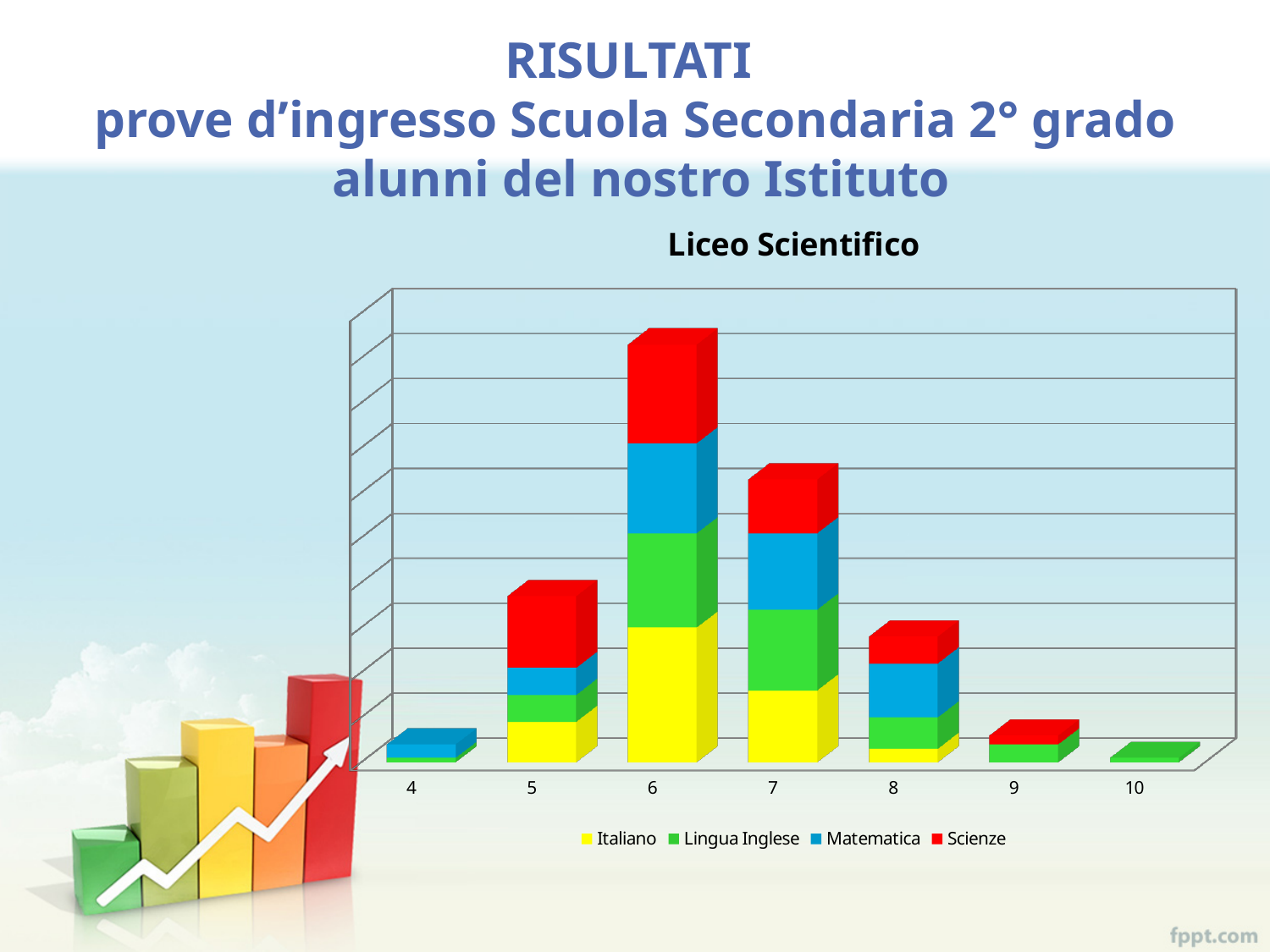
Which stacked bar is taller, category 6 or category 7? 6 Which series is the only one with a visible segment in category 10? Lingua Inglese Which stacked bar is taller, category 5 or category 8? 5 How many categories are shown on the x axis? 7 Which stacked bar is taller, category 4 or category 9? 9 Which category has the shortest stacked bar? 10 How many series does the legend list? 4 Which category has the tallest stacked bar? 6 Do the stacked bar totals rise or fall from category 6 to category 10? Fall What is the title of the chart? Liceo Scientifico What kind of chart is shown on the slide? Stacked bar chart Which series is shown in red in the legend? Scienze